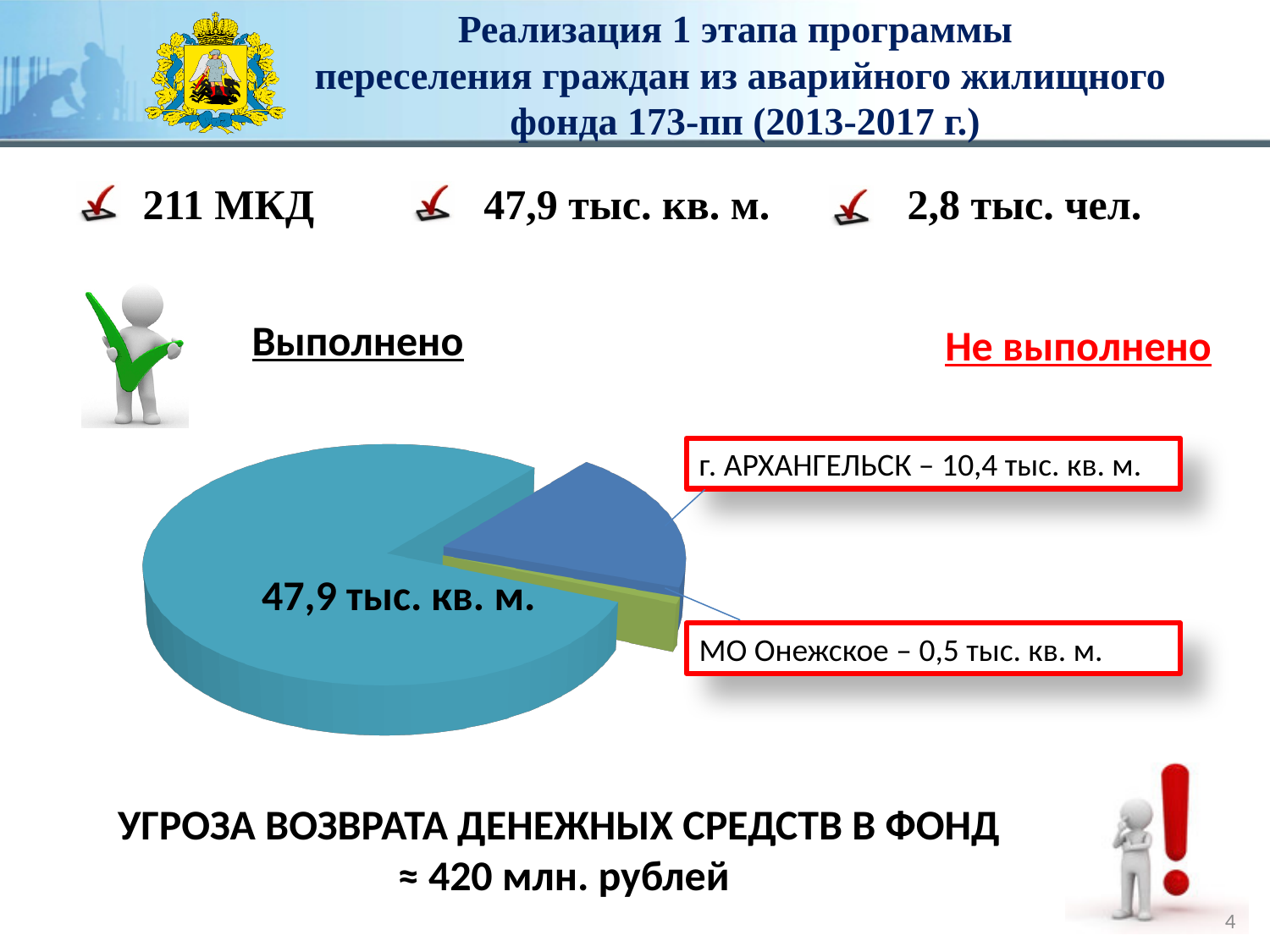
How many slices does the pie chart have? 3 Which slice of the pie chart is the smallest? МО Онежское What is the difference between the completed (Выполнено) value and the г. АРХАНГЕЛЬСК value in the pie chart? 37,5 тыс. кв. м. Which slice of the pie chart is the largest? Выполнено (47,9 тыс. кв. м.) What is the difference between the г. АРХАНГЕЛЬСК value and the МО Онежское value in the pie chart? 9,9 тыс. кв. м. What value is given for МО Онежское in the pie chart? 0,5 тыс. кв. м. What kind of chart is shown on the slide? Pie chart What colour is the largest slice of the pie chart? Teal (light blue) What value is given for г. АРХАНГЕЛЬСК in the pie chart? 10,4 тыс. кв. м. Which is larger in the pie chart: г. АРХАНГЕЛЬСК or МО Онежское? г. АРХАНГЕЛЬСК What value is printed on the largest slice of the pie chart? 47,9 тыс. кв. м. Which two slices of the pie chart are labelled as not completed (Не выполнено)? г. АРХАНГЕЛЬСК and МО Онежское